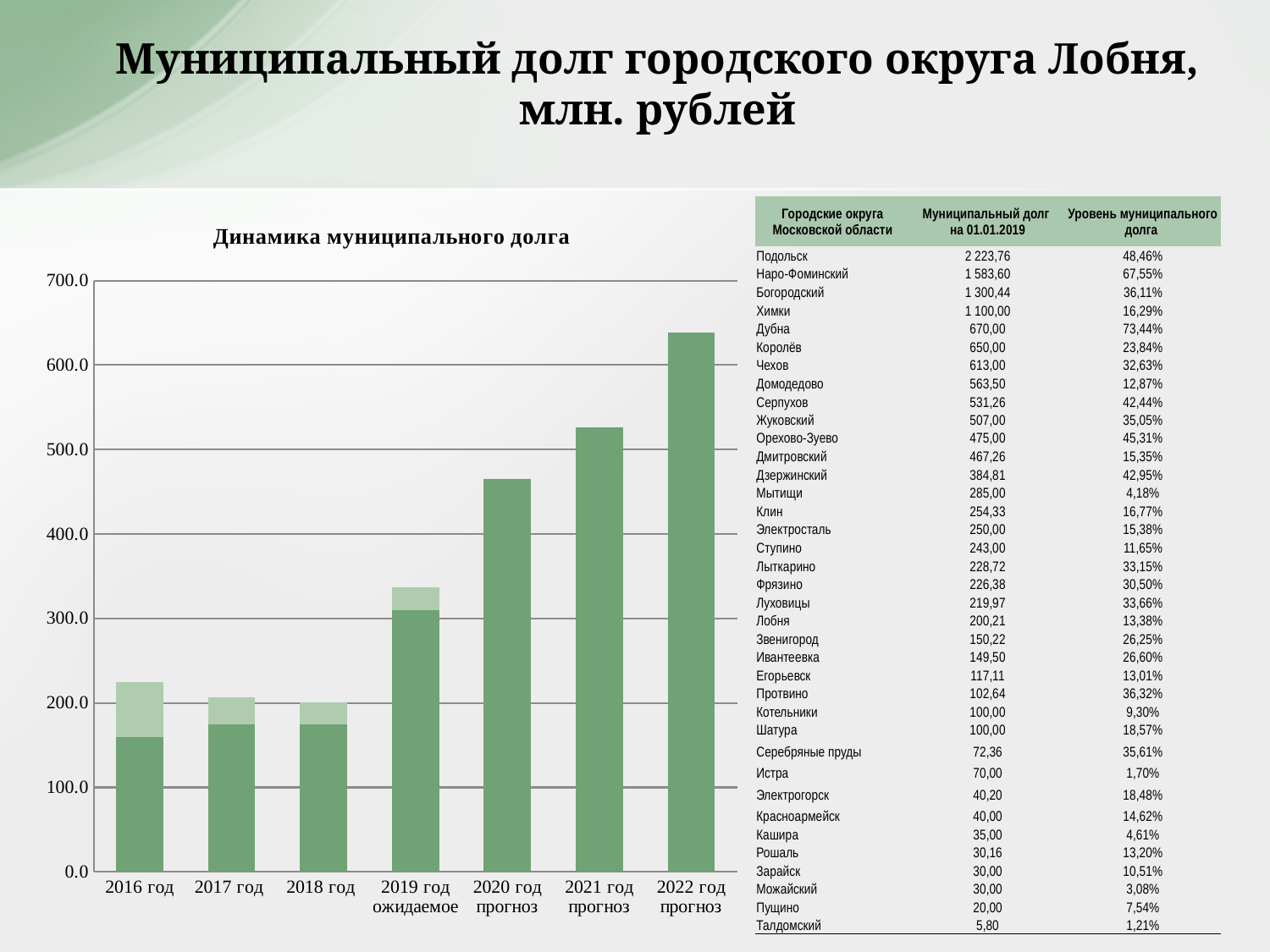
In the "Динамика муниципального долга" chart, is the total value for 2021 год прогноз greater or less than 500? greater In the "Динамика муниципального долга" chart, is the total value for 2020 год прогноз greater or less than 500? less What is the highest tick value shown on the y axis of the "Динамика муниципального долга" chart? 700.0 In the "Динамика муниципального долга" chart, which bar is taller: 2019 год ожидаемое or 2020 год прогноз? 2020 год прогноз In the "Динамика муниципального долга" chart, is the total value for 2019 год ожидаемое greater or less than 300? greater In the "Динамика муниципального долга" chart, which category has the highest bar? 2022 год прогноз In the "Динамика муниципального долга" chart, which bar is taller: 2022 год прогноз or 2016 год? 2022 год прогноз What kind of chart is "Динамика муниципального долга"? bar chart In the "Динамика муниципального долга" chart, do the values rise or fall from 2019 год ожидаемое to 2022 год прогноз? rise How many categories are shown on the x axis of the "Динамика муниципального долга" chart? 7